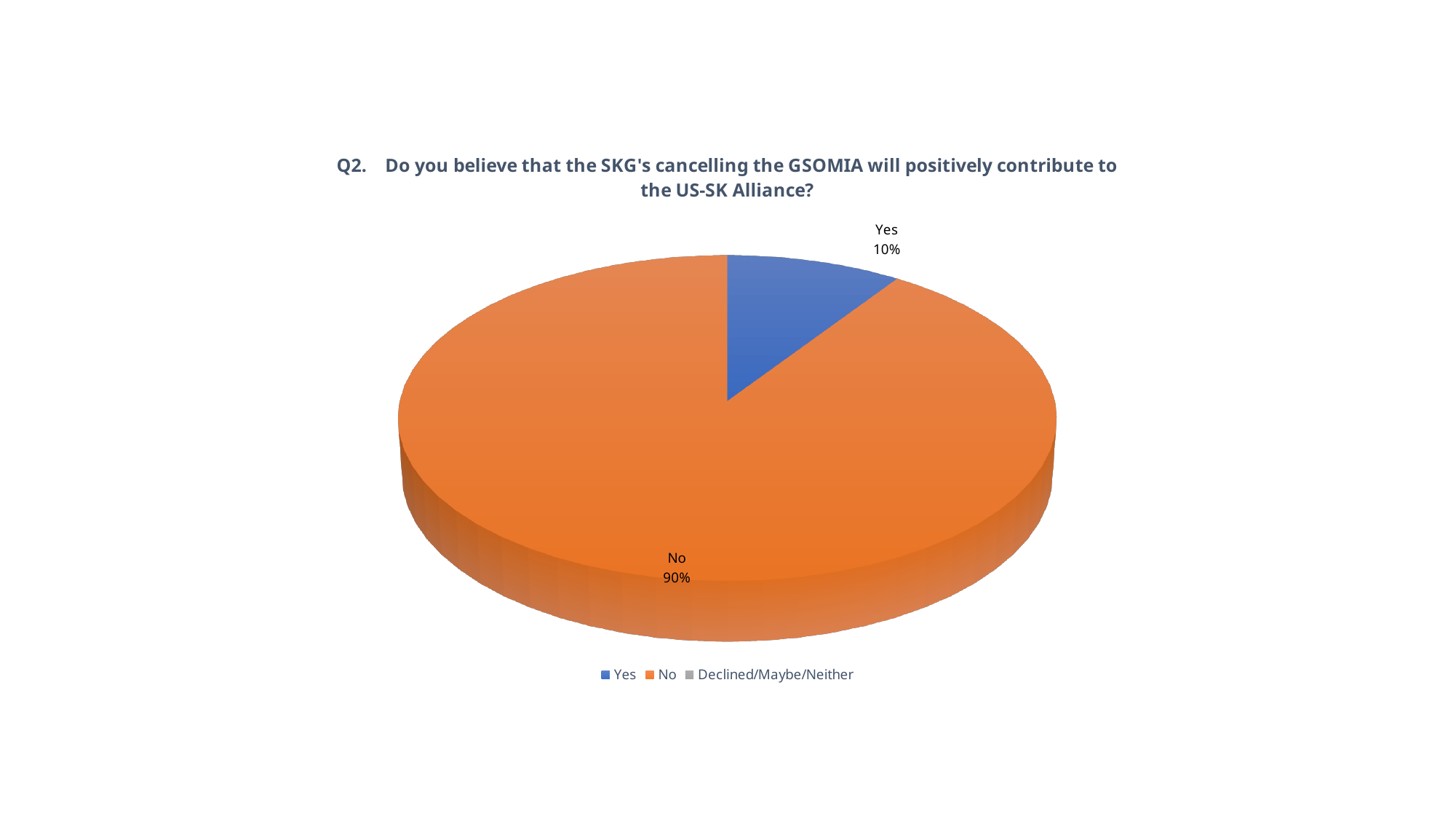
How many entries does the legend list? 3 What is the third legend entry, after Yes and No? Declined/Maybe/Neither What kind of chart is shown on the slide? pie chart What share of the pie does the "No" slice represent? 90% What share of the pie does the "Yes" slice represent? 10% What is the difference in percentage points between the "No" and "Yes" slices? 80 percentage points Which of the two labelled slices, Yes or No, is larger? No Which category has the largest slice of the pie? No How many slices are visibly labelled with a percentage on the pie? 2 What colour is the "Yes" slice? blue